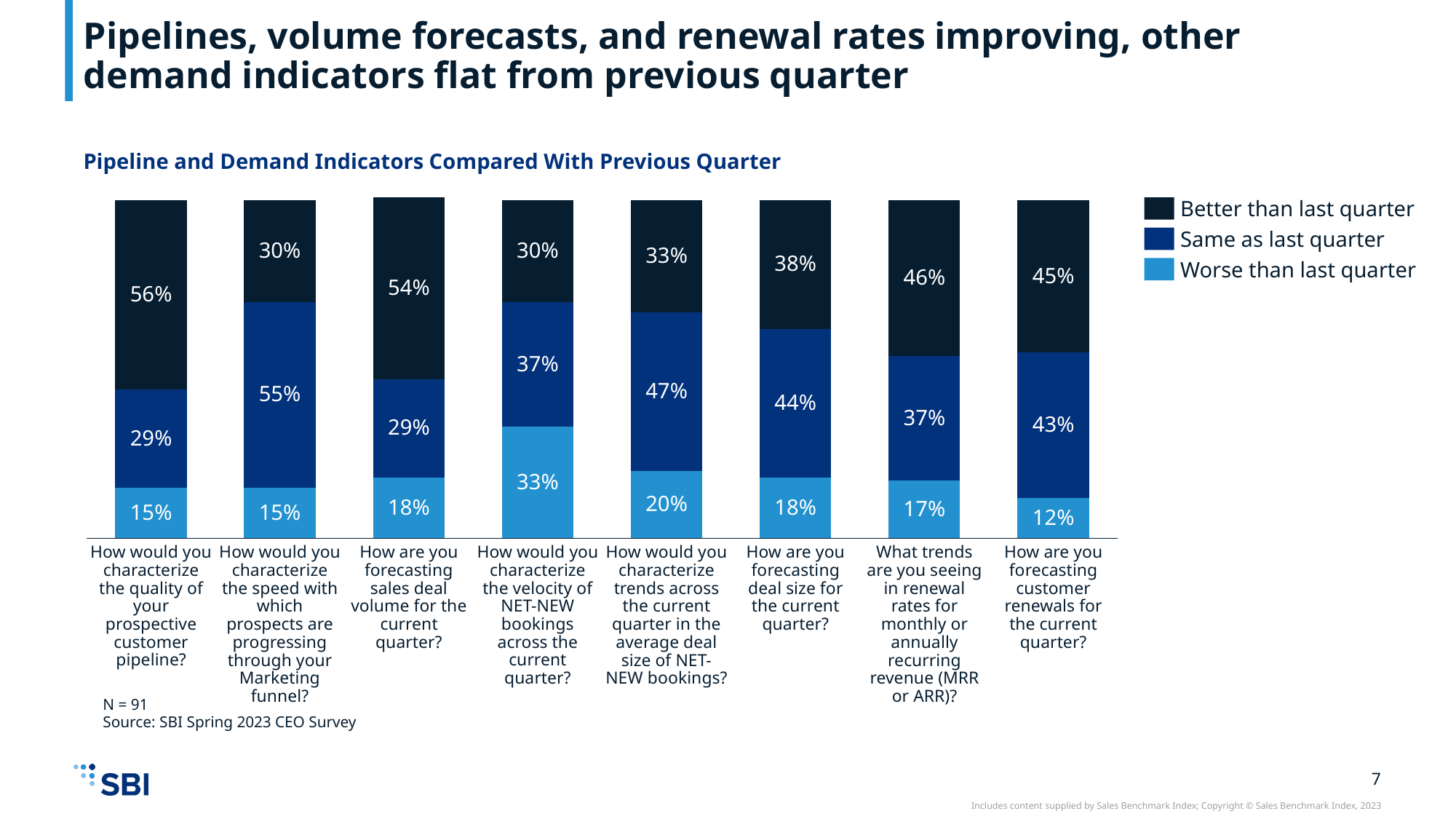
What is the total of the three segments in the bar for forecasting customer renewals for the current quarter? 100% What kind of chart is shown on the slide? Stacked bar chart Which survey question has the lowest 'Worse than last quarter' percentage? How are you forecasting customer renewals for the current quarter? What is the difference between the 'Better than last quarter' percentages for forecasting sales deal volume and forecasting deal size? 16% What share of respondents said the speed with which prospects are progressing through the Marketing funnel is the same as last quarter? 55% What is the title of the chart? Pipeline and Demand Indicators Compared With Previous Quarter How many bars (survey questions) are shown in the chart? 8 Which is larger: the 'Same as last quarter' share for trends in average deal size of NET-NEW bookings, or the 'Same as last quarter' share for renewal rates for MRR or ARR? Trends in average deal size of NET-NEW bookings (47%) Which survey question has the highest 'Better than last quarter' percentage? How would you characterize the quality of your prospective customer pipeline? What percentage said the velocity of NET-NEW bookings across the current quarter is worse than last quarter? 33% What percentage of respondents said the quality of their prospective customer pipeline is better than last quarter? 56% How many series does the legend list? 3